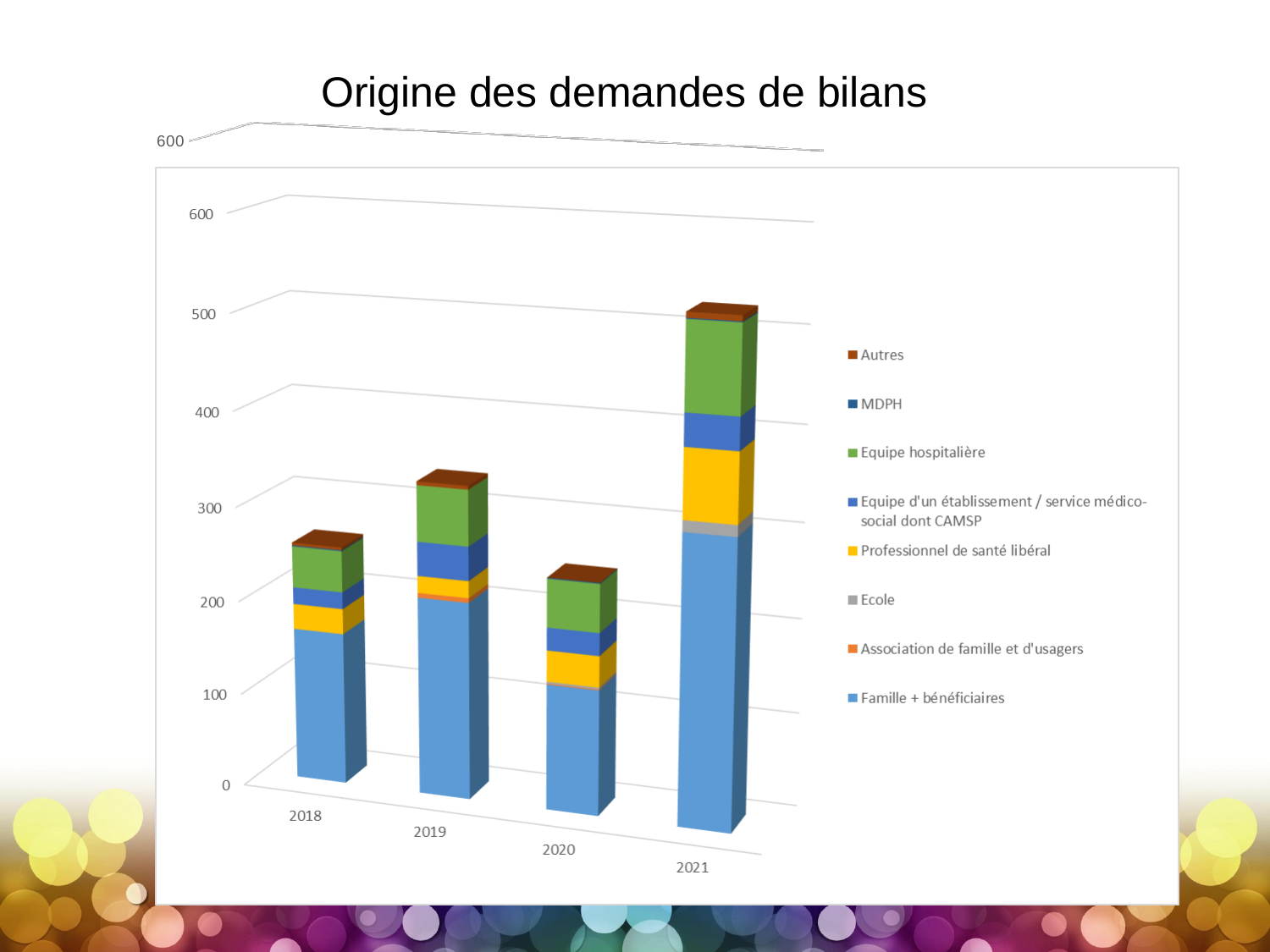
Is the total for 2020 greater or less than 300? less Is the total for 2021 greater or less than 400? greater Does the total number of requests rise or fall from 2020 to 2021? rise Which year has the lowest total number of requests? 2020 Is the total for 2018 greater or less than 200? greater Which series is shown in light blue at the bottom of each bar? Famille + bénéficiaires How many series does the legend list? 8 How many years are shown on the x axis of the chart? 4 What kind of chart is shown on the slide? Stacked bar chart Which year has a larger total, 2019 or 2021? 2021 What is the title of the chart? Origine des demandes de bilans Which year has the highest total number of requests? 2021